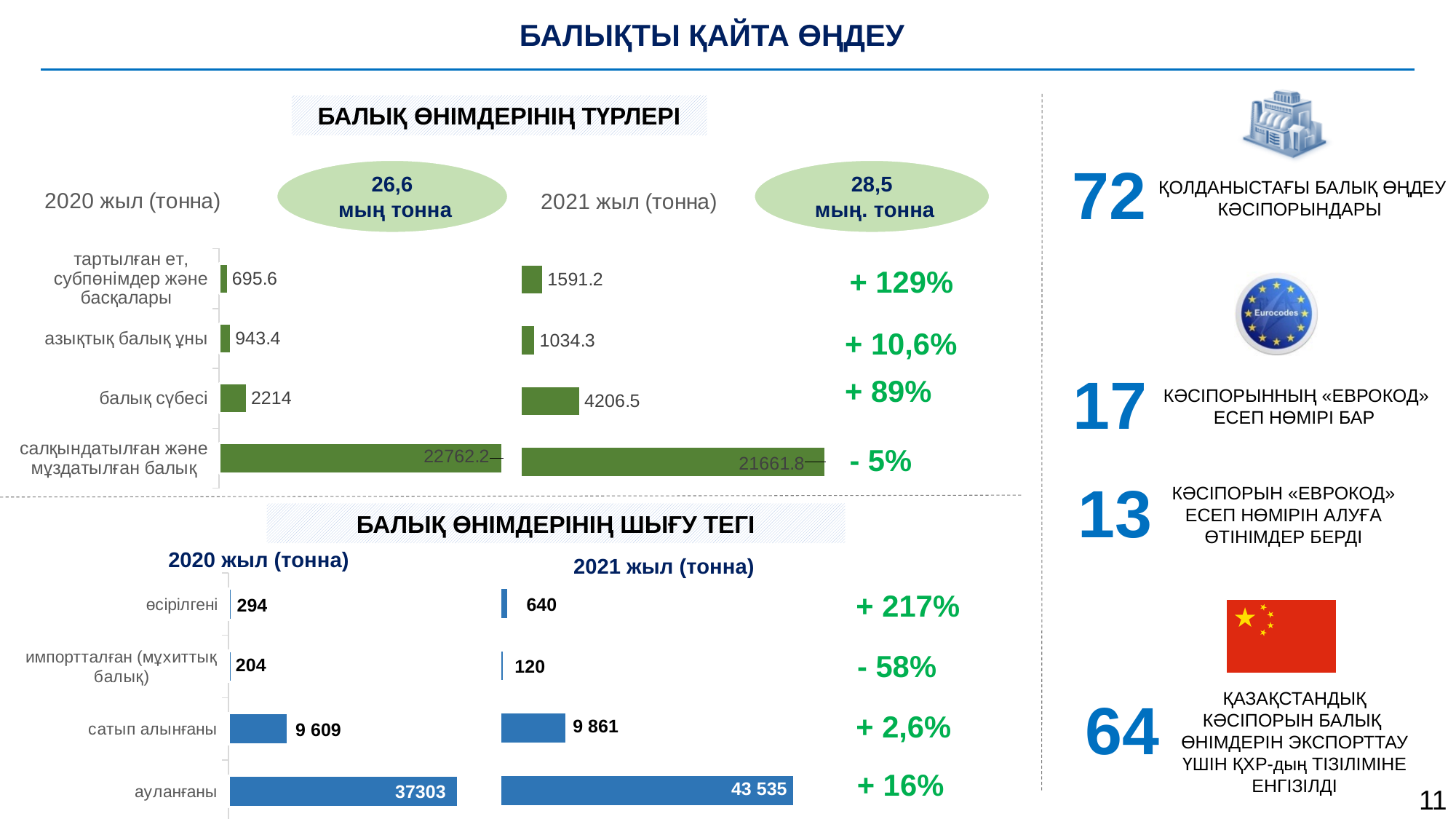
What kind of chart is used in the 'БАЛЫҚ ӨНІМДЕРІНІҢ ШЫҒУ ТЕГІ' section? Bar chart In the 'БАЛЫҚ ӨНІМДЕРІНІҢ ШЫҒУ ТЕГІ' chart, what is the 2021 value for 'ауланғаны'? 43 535 In the 'БАЛЫҚ ӨНІМДЕРІНІҢ ТҮРЛЕРІ' chart, what is the 2020 value for 'балық сүбесі'? 2214 In the 'БАЛЫҚ ӨНІМДЕРІНІҢ ТҮРЛЕРІ' chart, which category has the highest 2021 value? салқындатылған және мұздатылған балық In the 'БАЛЫҚ ӨНІМДЕРІНІҢ ШЫҒУ ТЕГІ' chart, what is the difference between the 2021 and 2020 values for 'өсірілгені'? 346 In the 'БАЛЫҚ ӨНІМДЕРІНІҢ ТҮРЛЕРІ' chart, what is the difference between the 2021 and 2020 values for 'балық сүбесі'? 1992.5 In the 'БАЛЫҚ ӨНІМДЕРІНІҢ ШЫҒУ ТЕГІ' chart, which is larger for 'импортталған (мұхиттық балық)': the 2020 value or the 2021 value? 2020 In the 'БАЛЫҚ ӨНІМДЕРІНІҢ ТҮРЛЕРІ' chart, how many product categories are shown? 4 What percentage change is shown for 'ауланғаны' in the 'БАЛЫҚ ӨНІМДЕРІНІҢ ШЫҒУ ТЕГІ' chart? + 16% In the 'БАЛЫҚ ӨНІМДЕРІНІҢ ТҮРЛЕРІ' chart, what is the 2021 value for 'азықтық балық ұны'? 1034.3 In the 'БАЛЫҚ ӨНІМДЕРІНІҢ ТҮРЛЕРІ' chart, which category has the lowest 2020 value? тартылған ет, субпөнімдер және басқалары In the 'БАЛЫҚ ӨНІМДЕРІНІҢ ШЫҒУ ТЕГІ' chart, what is the 2020 value for 'сатып алынғаны'? 9 609